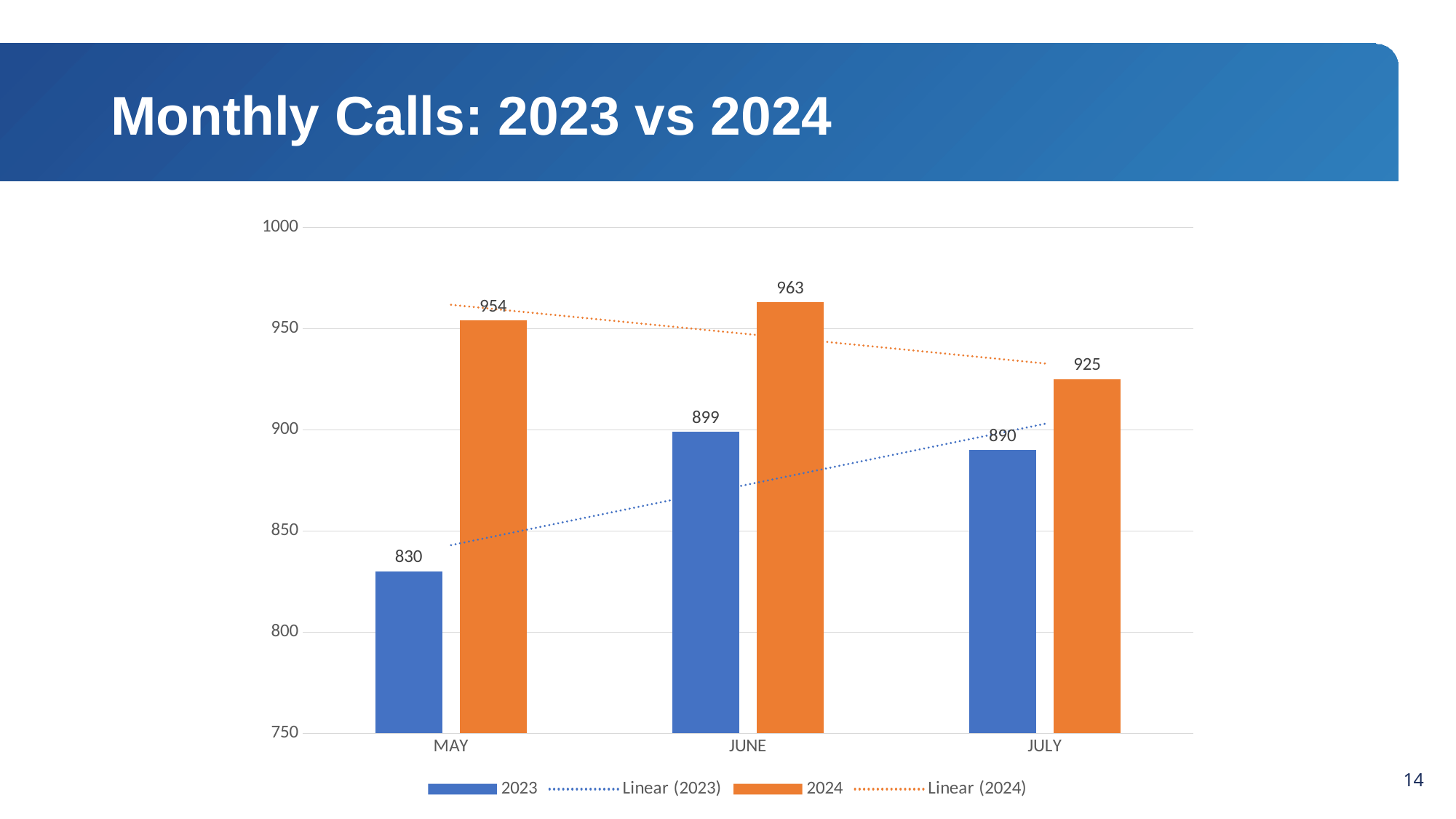
What kind of chart is shown on the slide? Bar chart How many months are shown on the x axis? 3 How many entries does the legend list? 4 What is the difference between the 2024 and 2023 values in May? 124 Which month has the highest value for the 2024 series? June Which month has the lowest value for the 2023 series? May Which is larger in July: the 2023 value or the 2024 value? 2024 What is the value for 2024 in June? 963 What is the value for 2023 in May? 830 What is the value for 2024 in July? 925 Does the 2024 series rise or fall from June to July? Fall What is the difference between the 2023 values for June and July? 9